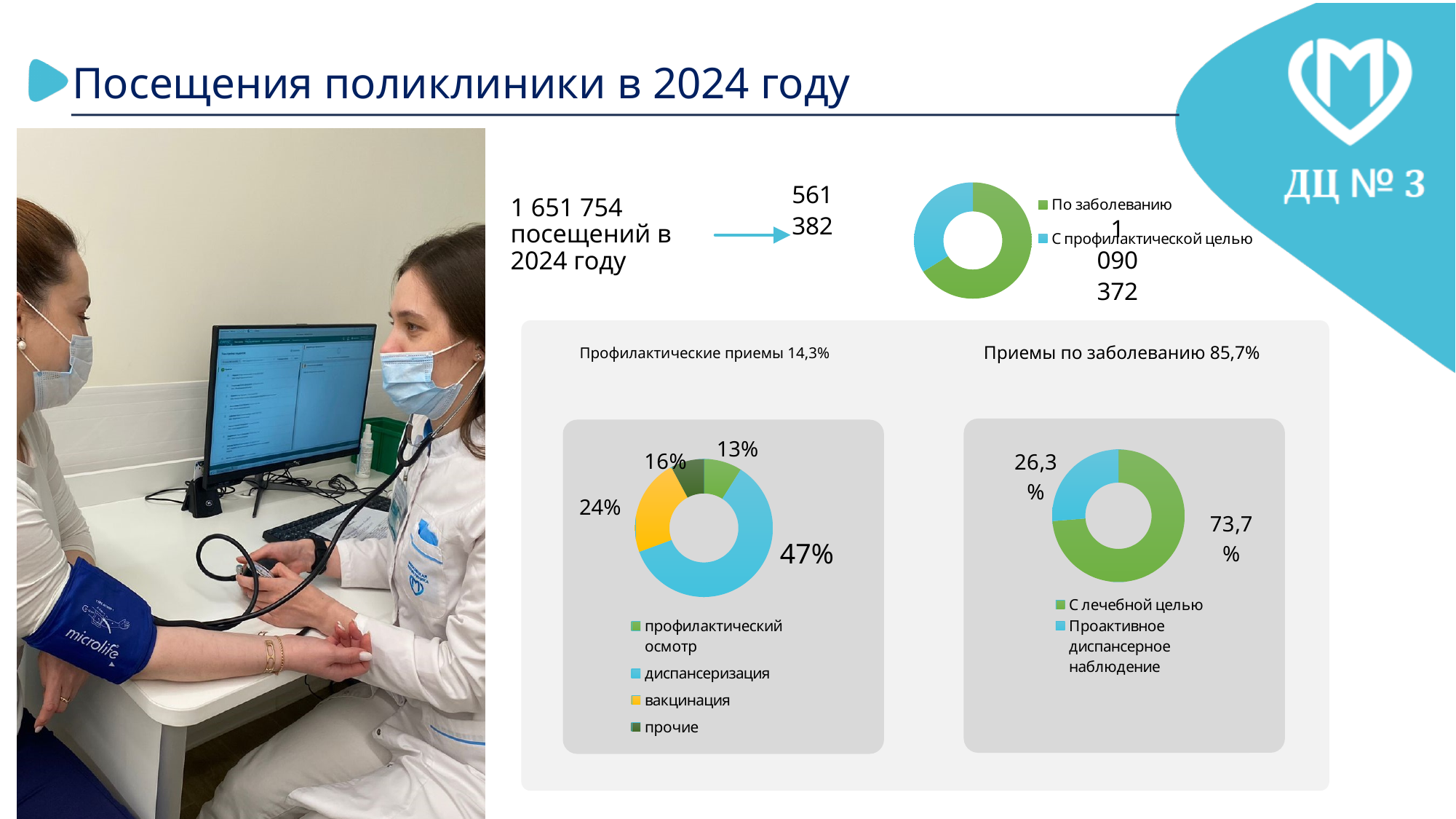
In the 'Профилактические приемы 14,3%' chart, what share is прочие? 16% In the 'Профилактические приемы 14,3%' chart, which category has the smallest share? профилактический осмотр In the 'Профилактические приемы 14,3%' chart, how many percentage points larger is диспансеризация than вакцинация? 23% In the 'Профилактические приемы 14,3%' chart, which category has the largest share? диспансеризация What type of chart is the 'Приемы по заболеванию 85,7%' chart? Doughnut (pie) chart In the 'Профилактические приемы 14,3%' chart, what share is профилактический осмотр? 13% In the 'Профилактические приемы 14,3%' chart, what share is вакцинация? 24% In the 'Профилактические приемы 14,3%' chart, what share is диспансеризация? 47% In the 'Приемы по заболеванию 85,7%' chart, what share is Проактивное диспансерное наблюдение? 26,3% In the small doughnut chart at the top of the slide, which is larger: По заболеванию or С профилактической целью? По заболеванию How many categories does the 'Профилактические приемы 14,3%' chart show? 4 In the 'Приемы по заболеванию 85,7%' chart, what share is С лечебной целью? 73,7%